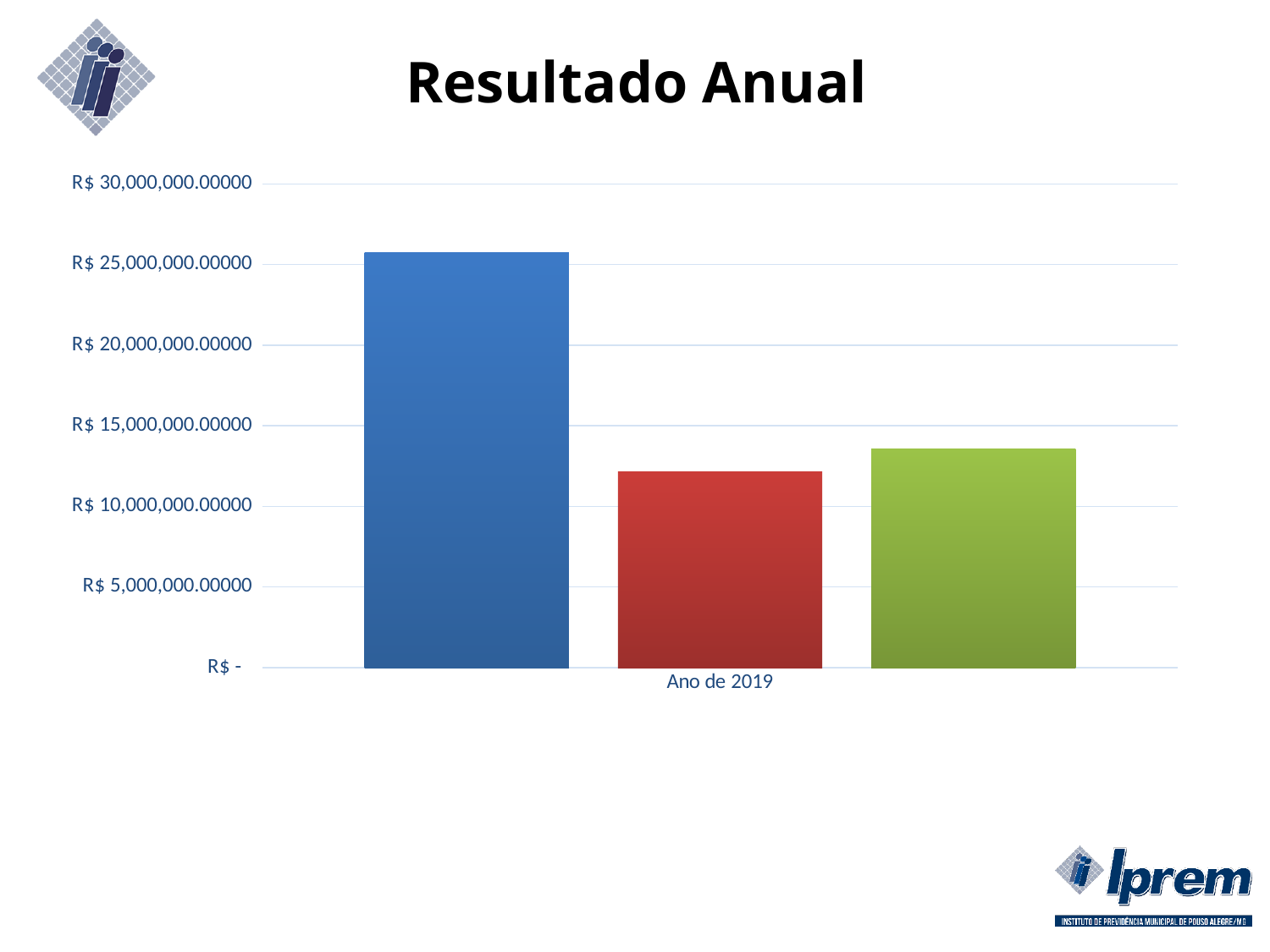
Which bar is the shortest in the chart? the red bar Is the value of the green bar greater or less than R$ 10,000,000.00000? greater Is the value of the green bar greater or less than R$ 15,000,000.00000? less What is the category label shown on the x axis? Ano de 2019 How many bars are plotted in the chart? 3 What kind of chart is shown on the slide? bar chart Is the value of the blue bar greater or less than R$ 20,000,000.00000? greater Which bar is the tallest in the chart? the blue bar Which is larger, the green bar or the red bar? the green bar What is the title of the chart? Resultado Anual Which is larger, the blue bar or the red bar? the blue bar